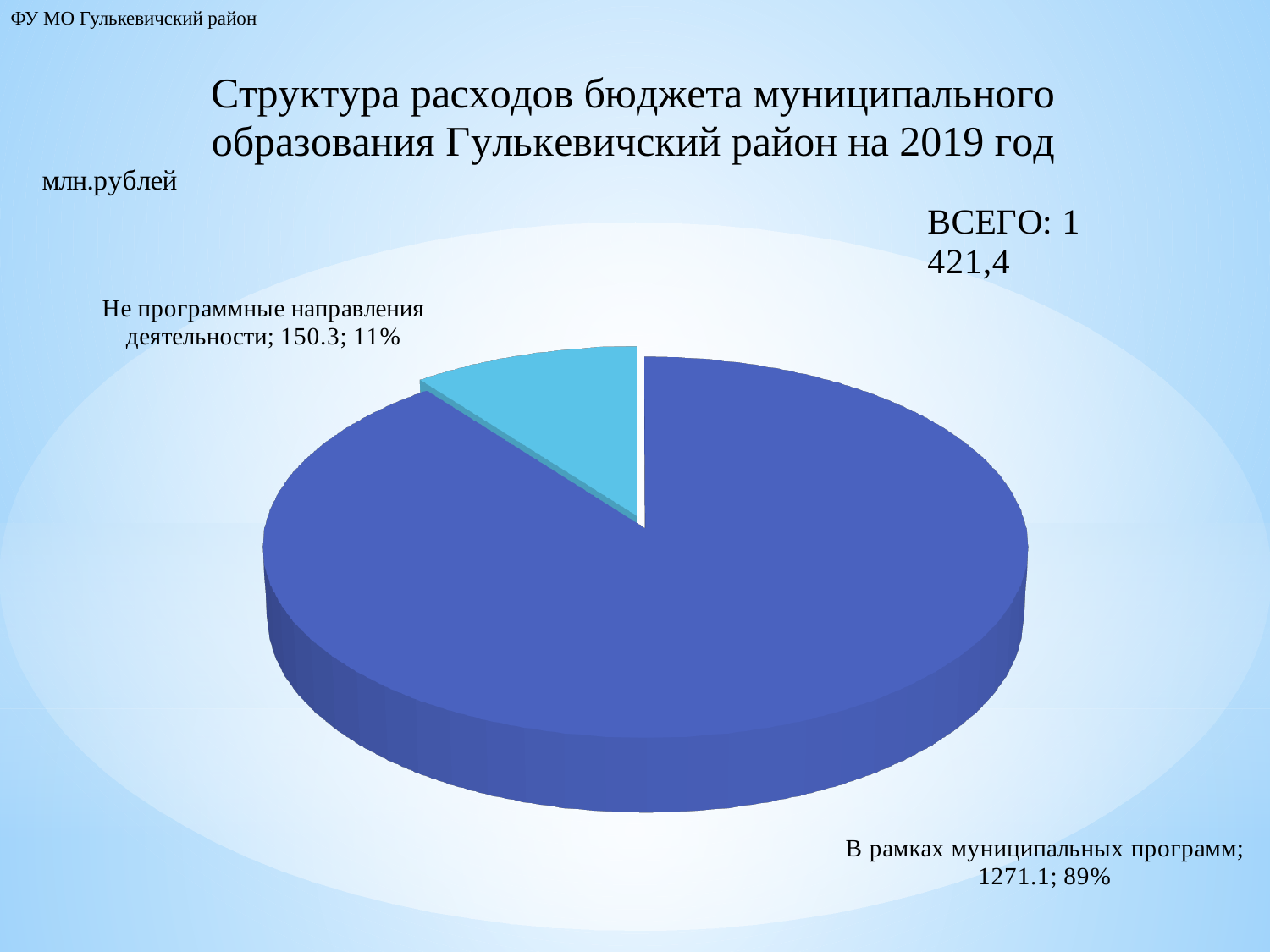
Which category has the largest slice of the pie? В рамках муниципальных программ In what units are the values on the chart given? млн.рублей Which category has the smallest slice of the pie? Не программные направления деятельности What total (ВСЕГО) is shown on the slide? 1 421,4 What is the value for "В рамках муниципальных программ"? 1271.1 Which is larger: "В рамках муниципальных программ" or "Не программные направления деятельности"? В рамках муниципальных программ How many slices does the pie chart have? 2 What is the difference between the values for "В рамках муниципальных программ" and "Не программные направления деятельности"? 1120.8 What is the value for "Не программные направления деятельности"? 150.3 What share of the pie does "Не программные направления деятельности" take? 11% What kind of chart is shown on the slide? pie chart What share of the pie does "В рамках муниципальных программ" take? 89%